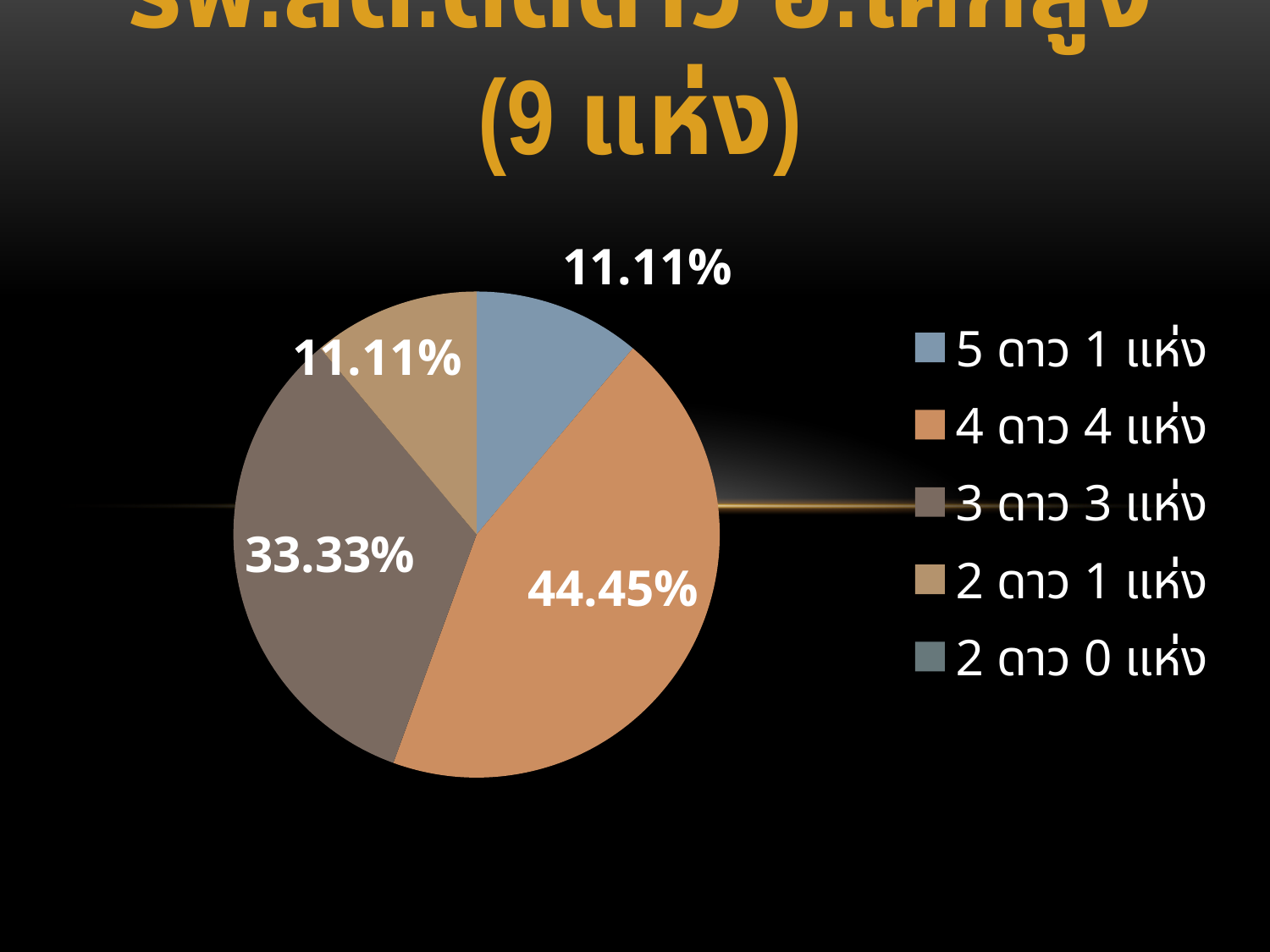
What colour is the "4 ดาว 4 แห่ง" slice in the pie chart? orange What is the difference in percentage points between the "3 ดาว 3 แห่ง" slice and the "5 ดาว 1 แห่ง" slice? 22.22% What percentage is shown for the "2 ดาว 1 แห่ง" slice? 11.11% What kind of chart is shown on the slide? pie chart How many entries does the legend list? 5 What percentage of the pie does the "4 ดาว 4 แห่ง" slice represent? 44.45% What is the difference in percentage points between the "4 ดาว 4 แห่ง" slice and the "3 ดาว 3 แห่ง" slice? 11.12% How many slices are visible in the pie chart? 4 Which slice is larger, "3 ดาว 3 แห่ง" or "2 ดาว 1 แห่ง"? 3 ดาว 3 แห่ง Which legend category has the largest slice of the pie? 4 ดาว 4 แห่ง What percentage is shown for the "5 ดาว 1 แห่ง" slice? 11.11% What percentage is shown for the "3 ดาว 3 แห่ง" slice? 33.33%